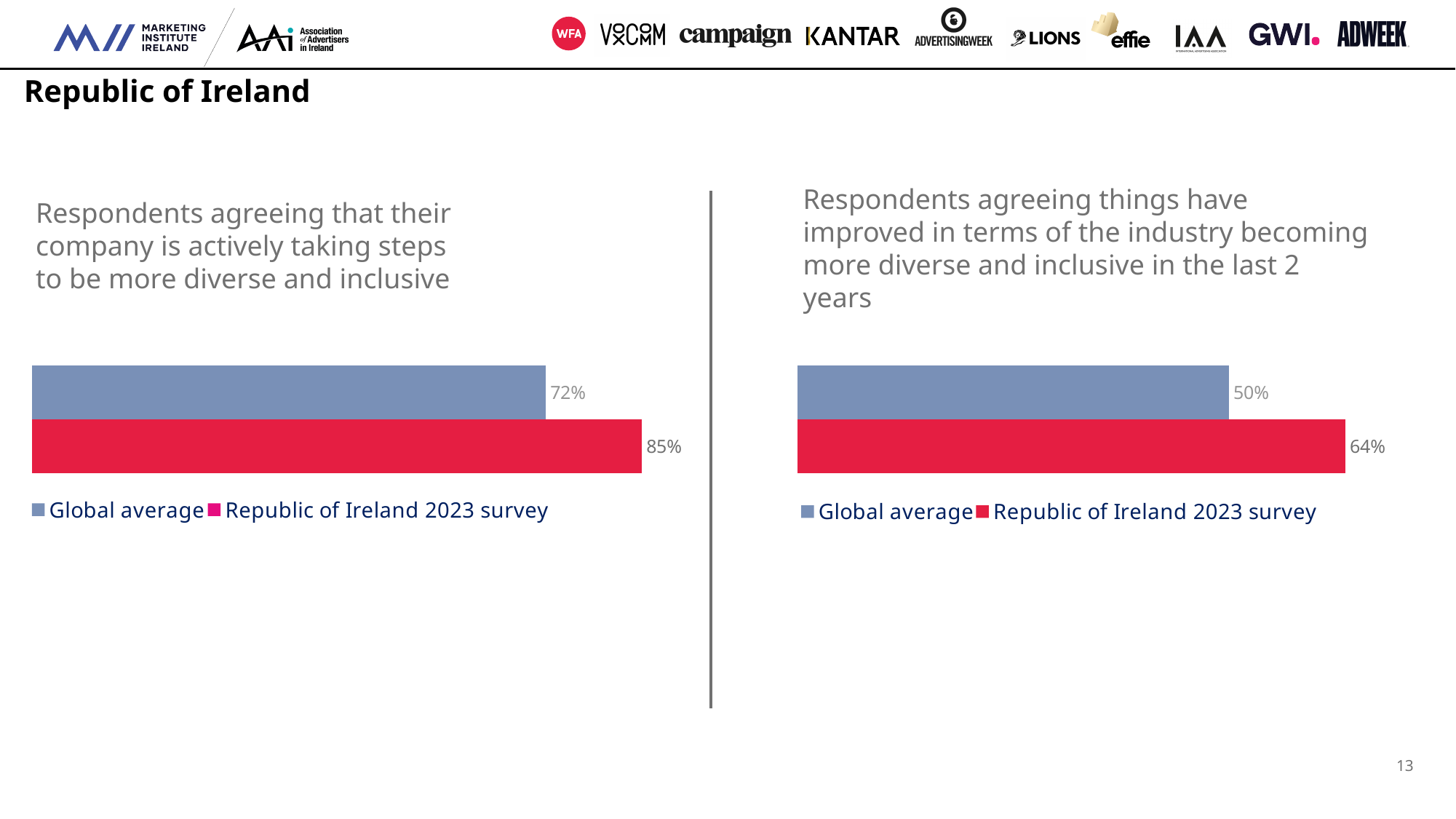
In the right chart (things have improved in the last 2 years), what is the value for the Global average? 50% In the right chart (things have improved in the last 2 years), what is the value for the Republic of Ireland 2023 survey? 64% In the right chart (things have improved in the last 2 years), what is the difference between the Republic of Ireland 2023 survey and the Global average? 14 percentage points In the left chart, what colour is the bar for the Republic of Ireland 2023 survey? Red In the right chart (things have improved in the last 2 years), which series has the lower value? Global average What kind of chart is the right chart (things have improved in the last 2 years)? Bar chart In the left chart (company actively taking steps to be more diverse and inclusive), what is the value for the Republic of Ireland 2023 survey? 85% In the left chart (company actively taking steps to be more diverse and inclusive), what is the value for the Global average? 72% In the left chart (company actively taking steps to be more diverse and inclusive), what is the difference between the Republic of Ireland 2023 survey and the Global average? 13 percentage points In the left chart (company actively taking steps to be more diverse and inclusive), which series has the higher value? Republic of Ireland 2023 survey How many series does the legend of the left chart list? 2 In the right chart (things have improved in the last 2 years), is the Global average or the Republic of Ireland 2023 survey value larger? Republic of Ireland 2023 survey